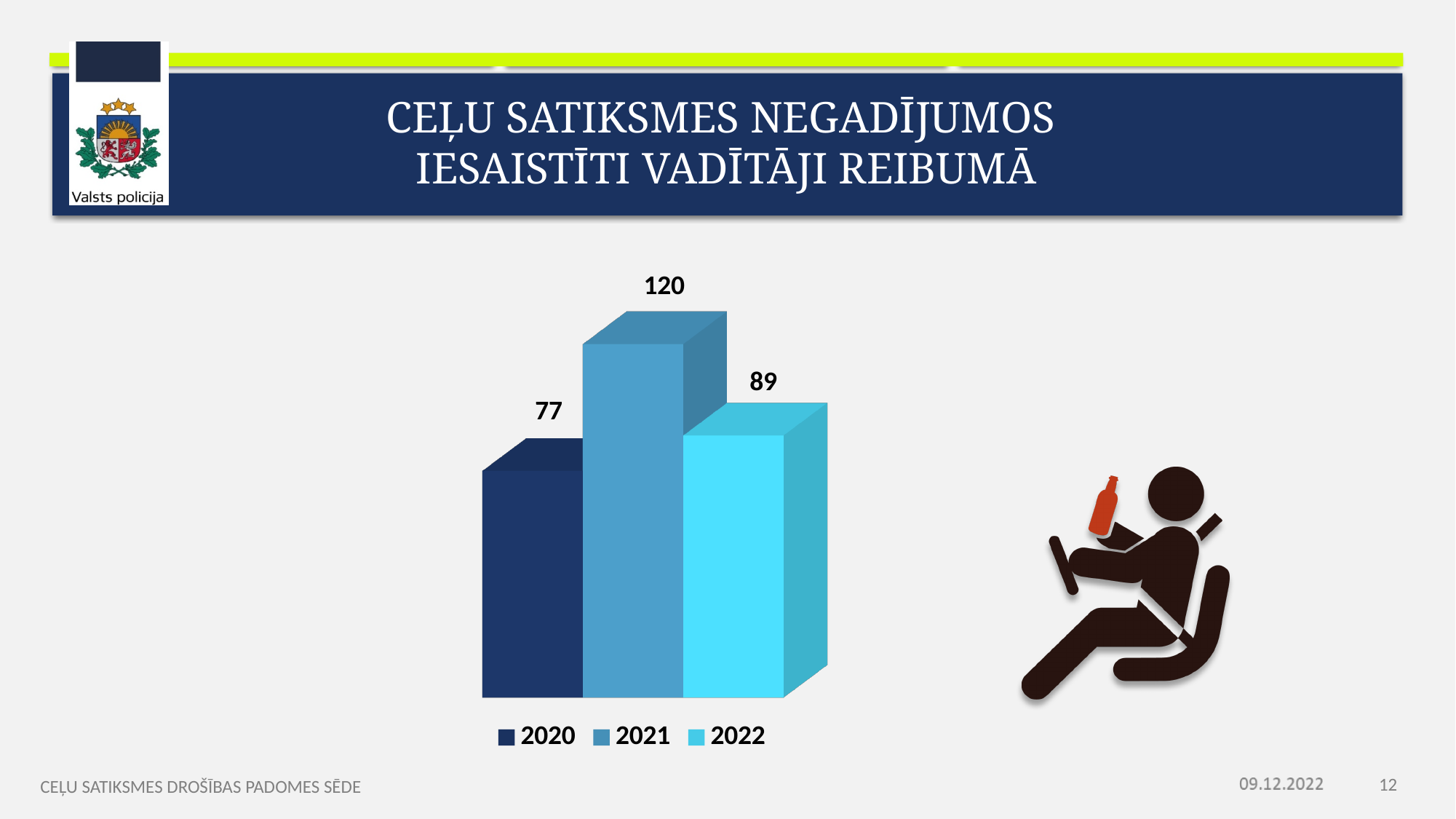
Which year has the lowest value? 2020 What is the difference between the values for 2021 and 2022? 31 What kind of chart is shown on the slide? bar chart What is the difference between the values for 2021 and 2020? 43 Which is larger, the value for 2022 or the value for 2020? 2022 What is the value for 2021? 120 Which year has the highest value? 2021 How many series does the legend list? 3 What is the total of the values for 2020, 2021 and 2022? 286 Which colour represents 2022 in the legend? light blue What is the value for 2022? 89 What is the value for 2020? 77